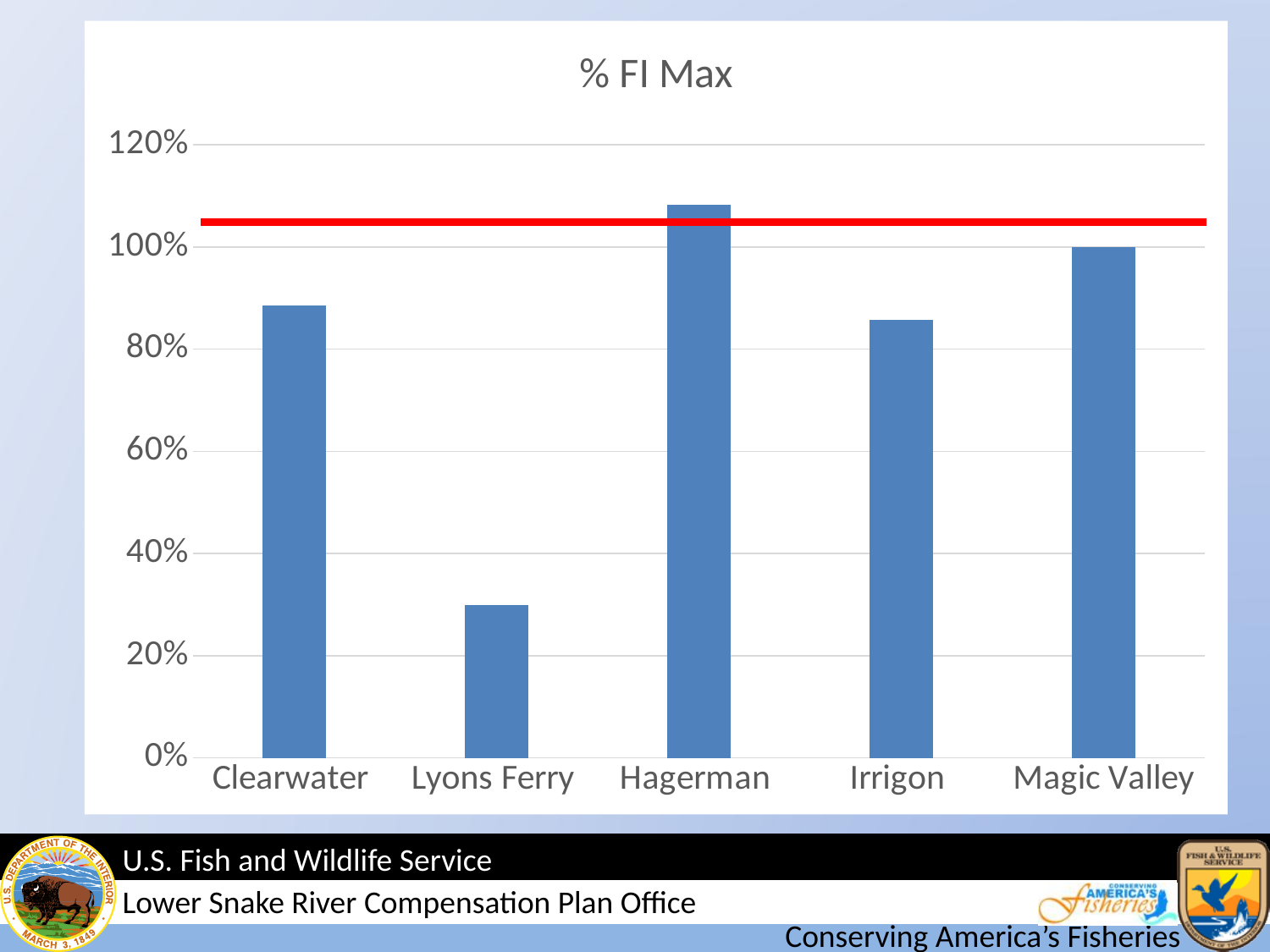
How many categories are shown on the x axis of the chart? 5 Which category has the highest value in the chart? Hagerman Which is larger, the value for Magic Valley or the value for Irrigon? Magic Valley What kind of chart is shown on the slide? bar chart Which is larger, the value for Clearwater or the value for Lyons Ferry? Clearwater What is the title of the chart? % FI Max Is the value for Lyons Ferry greater or less than 40%? less Which category has the lowest value in the chart? Lyons Ferry Is the value for Clearwater greater or less than 80%? greater Is the value for Irrigon greater or less than 100%? less What colour is the horizontal reference line drawn across the chart? red